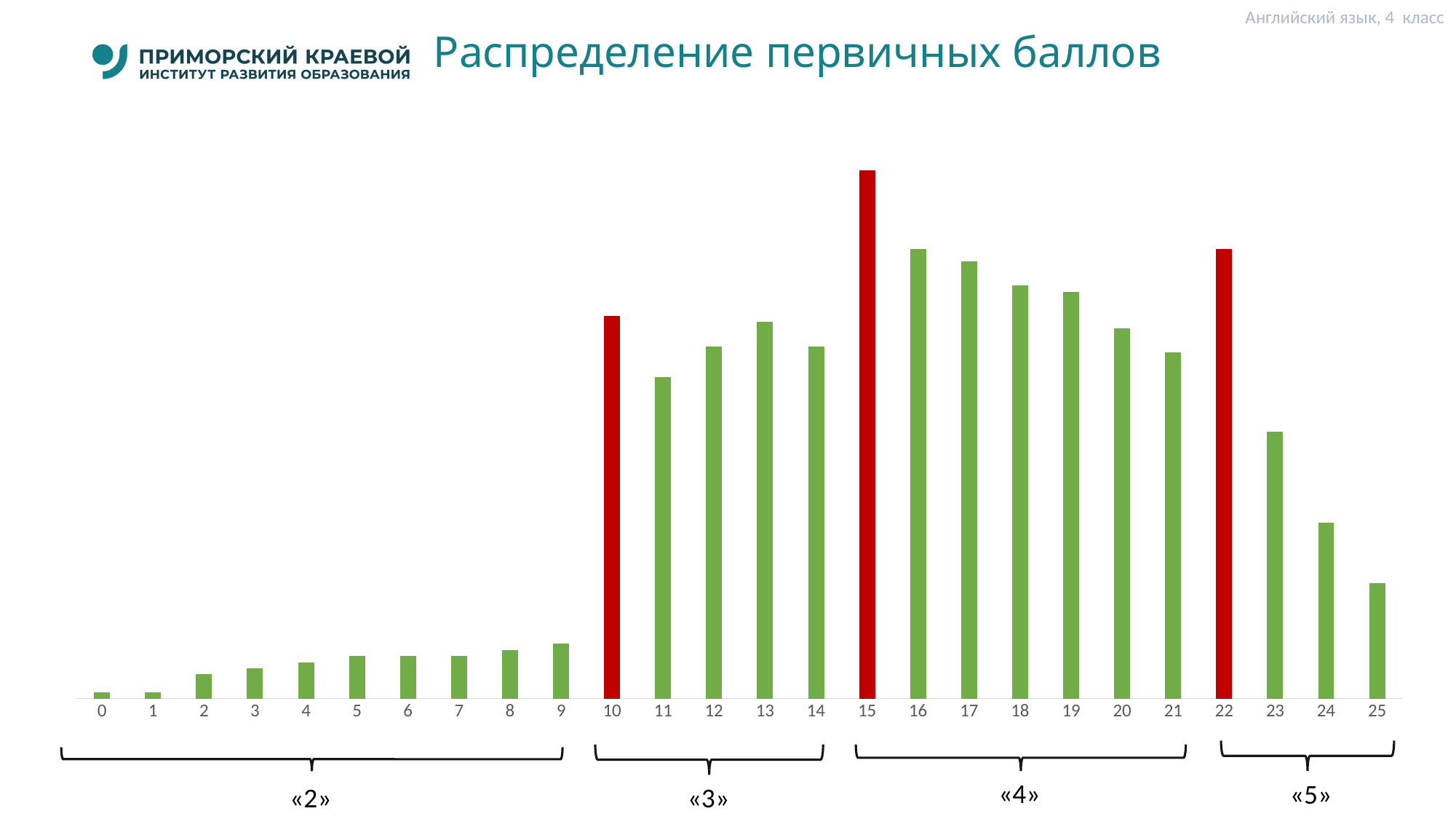
Which bar is taller, the one for score 23 or the one for score 24? 23 How many score categories are shown along the x axis? 26 Which grade bracket covers scores 15 to 21? «4» What type of chart is shown on the slide? Bar chart Which bar is taller, the one for score 10 or the one for score 22? 22 Do the bar heights rise or fall from score 1 to score 9? Rise Which score on the x axis has the highest bar? 15 Which bar is taller, the one for score 9 or the one for score 10? 10 Which scores are highlighted with red bars? 10, 15 and 22 How many bars are coloured red? 3 Do the bar heights rise or fall from score 22 to score 25? Fall